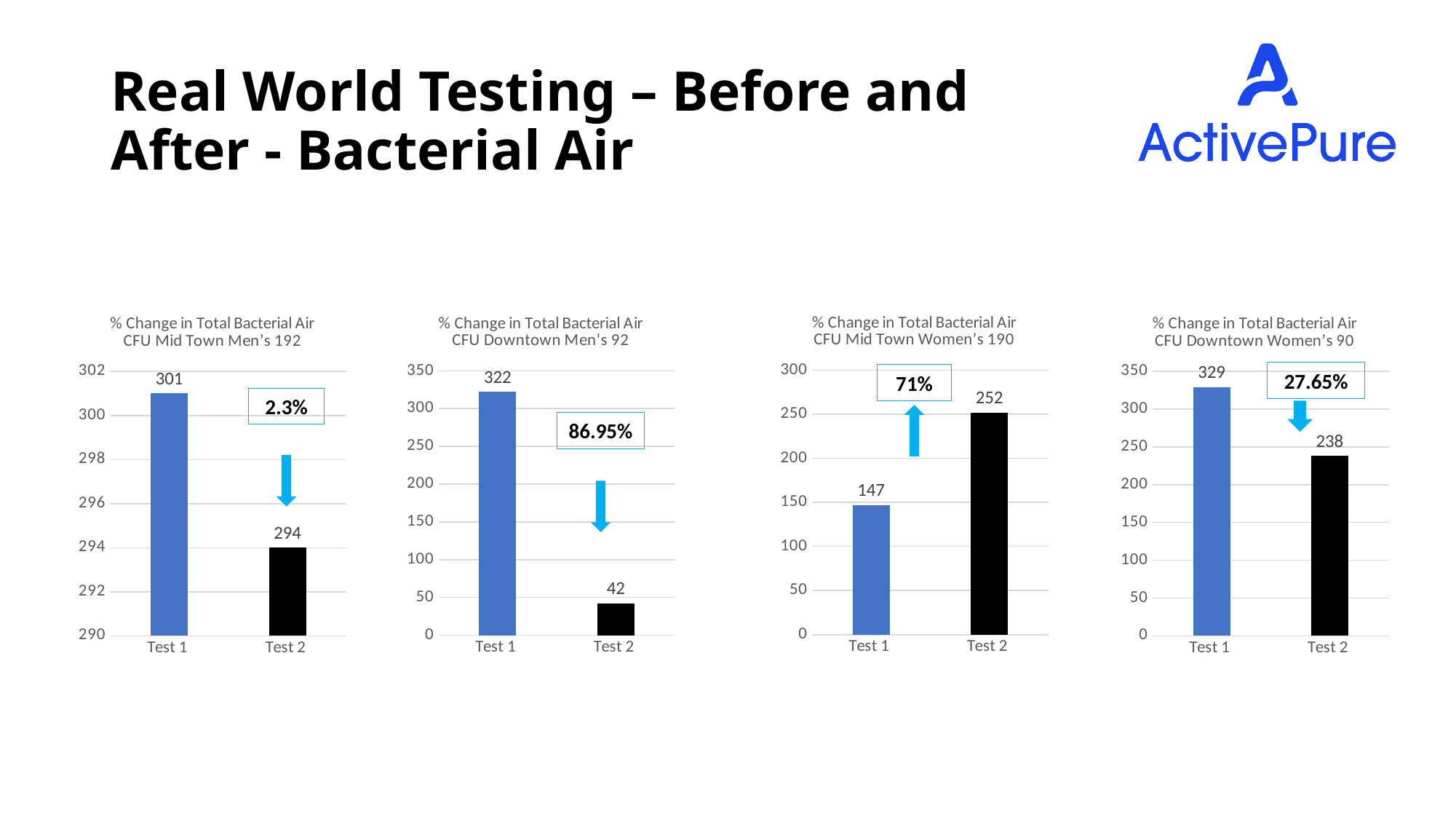
In the chart titled '% Change in Total Bacterial Air CFU Mid Town Men's 192', what is the value for Test 2? 294 What kind of chart is the chart titled '% Change in Total Bacterial Air CFU Mid Town Men's 192'? bar chart In the chart titled '% Change in Total Bacterial Air CFU Downtown Women's 90', what is the value for Test 2? 238 In the chart titled '% Change in Total Bacterial Air CFU Downtown Men's 92', what is the difference between Test 1 and Test 2? 280 In the chart titled '% Change in Total Bacterial Air CFU Mid Town Women's 190', which test has the higher value? Test 2 In the chart titled '% Change in Total Bacterial Air CFU Mid Town Men's 192', what is the value for Test 1? 301 How many categories are shown on the x axis of the chart titled '% Change in Total Bacterial Air CFU Downtown Men's 92'? 2 What percentage change is annotated on the chart titled '% Change in Total Bacterial Air CFU Downtown Men's 92'? 86.95% In the chart titled '% Change in Total Bacterial Air CFU Mid Town Women's 190', what is the value for Test 1? 147 In the chart titled '% Change in Total Bacterial Air CFU Downtown Women's 90', what is the difference between Test 1 and Test 2? 91 In the chart titled '% Change in Total Bacterial Air CFU Downtown Men's 92', what is the value for Test 2? 42 In the chart titled '% Change in Total Bacterial Air CFU Downtown Women's 90', is the value for Test 1 greater or less than 300? greater